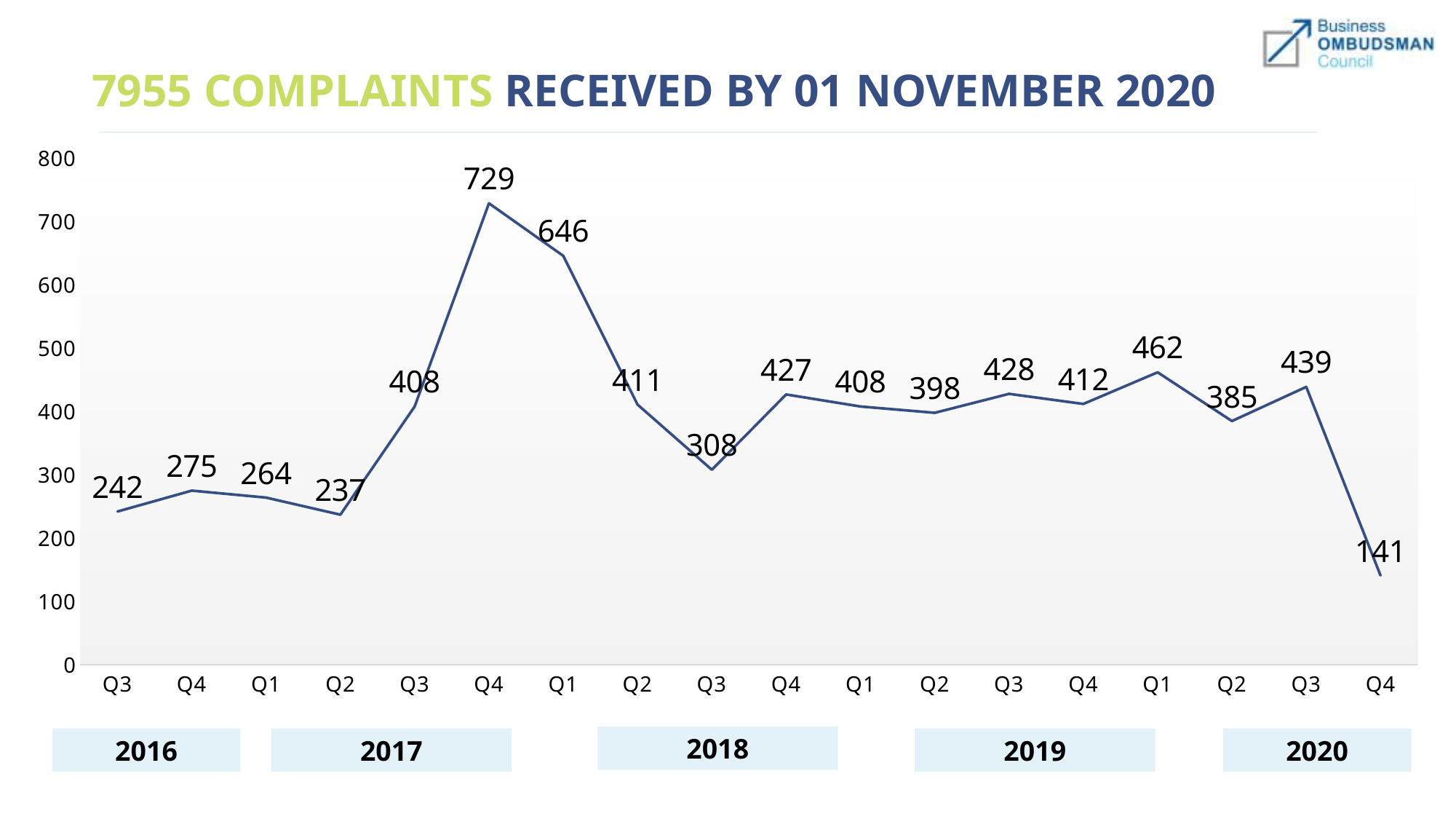
Which is larger, the value for Q3 2018 or the value for Q4 2018? Q4 2018 What kind of chart is shown on the slide? Line chart How many quarterly data points are plotted on the chart? 18 Do the values rise or fall from Q2 2017 to Q4 2017? Rise What is the number of complaints for Q2 2017? 237 What is the number of complaints for Q3 2020? 439 What is the number of complaints for Q4 2017? 729 Which quarter has the lowest number of complaints? Q4 2020 What is the difference between the values for Q4 2017 and Q1 2018? 83 Which quarter has the highest number of complaints? Q4 2017 Is the value for Q1 2018 greater or less than 600? greater What is the difference between the values for Q1 2020 and Q2 2020? 77